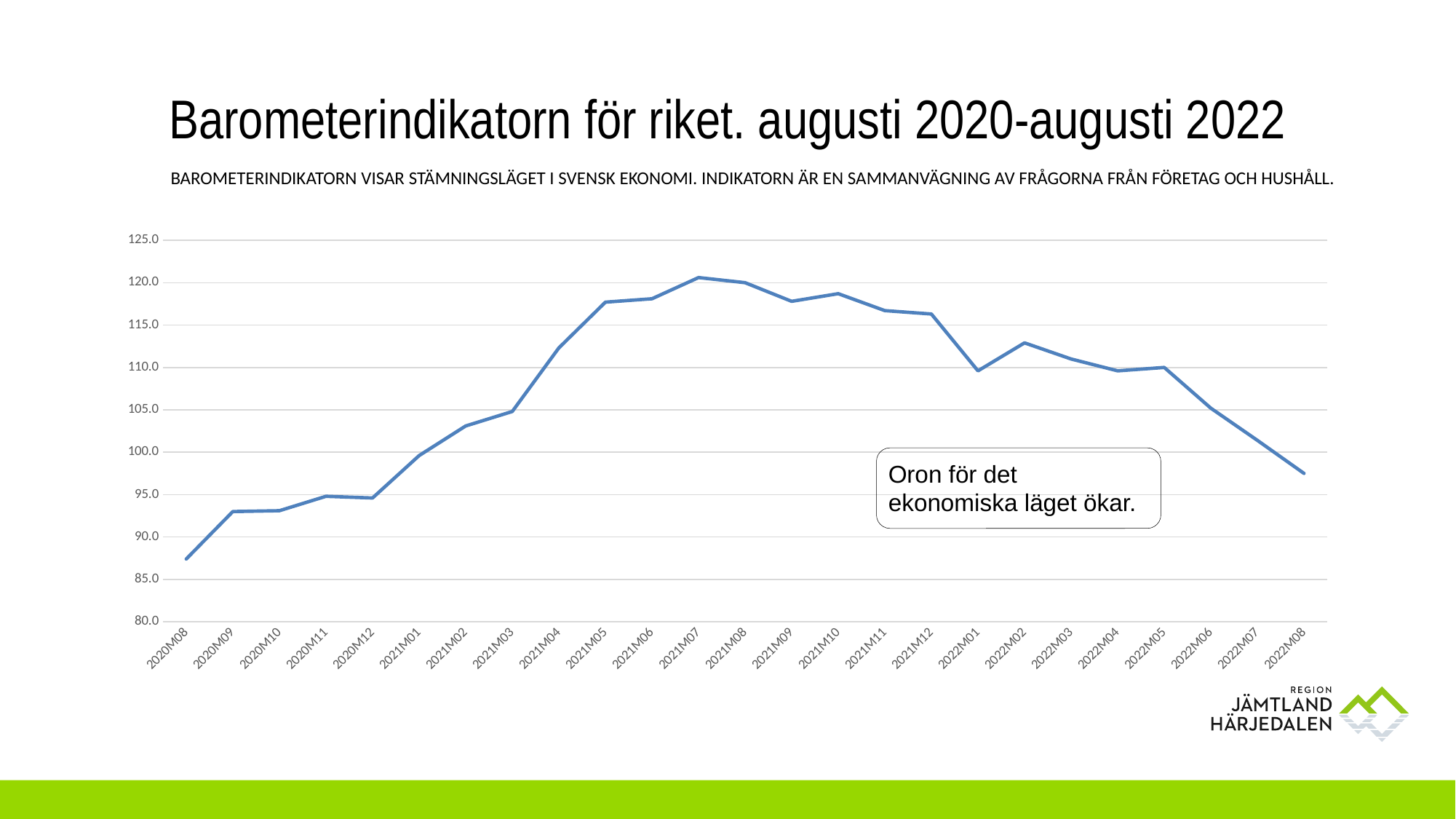
Is the value for 2021M05 greater or less than 115? greater What kind of chart is shown on the slide? line chart Is the value for 2022M08 greater or less than 100? less Do the values rise or fall from 2021M12 to 2022M08? fall Which month has the lowest value on the chart? 2020M08 What does the text box on the chart say? Oron för det ekonomiska läget ökar. Which is larger, the value for 2021M07 or the value for 2022M08? 2021M07 Is the value for 2021M02 greater or less than 100? greater Which is larger, the value for 2020M09 or the value for 2022M02? 2022M02 How many monthly data points are plotted on the chart? 25